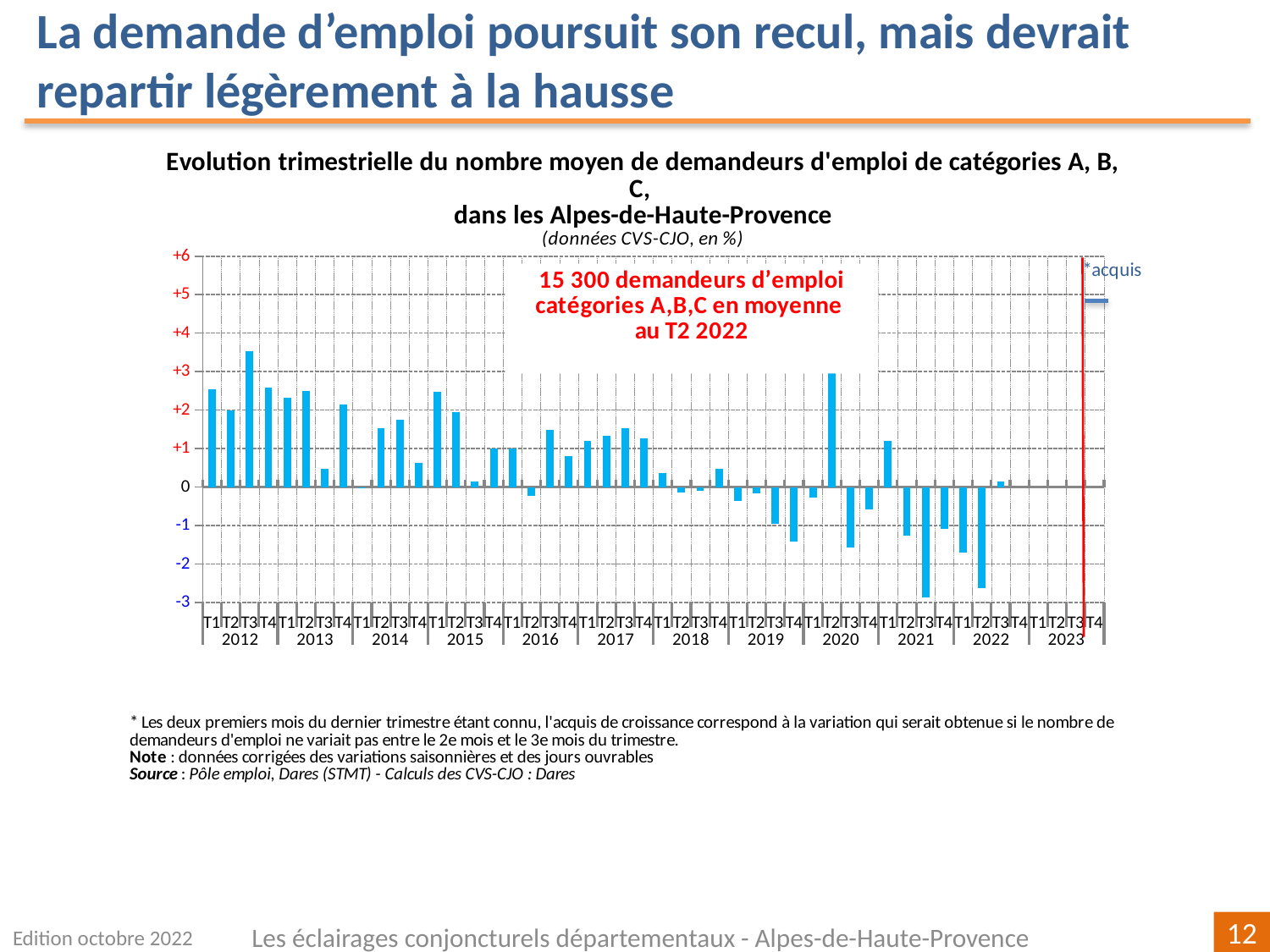
How many years are labelled along the x axis of the chart? 12 According to the text box on the chart, how many demandeurs d'emploi catégories A,B,C were there on average at T2 2022? 15 300 Between T1 2021 and T3 2021, do the values rise or fall? fall Which is lower, the value for T3 2021 or the value for T2 2022? T3 2021 Is the value for T4 2019 greater or less than -1? less What kind of chart is shown on the slide? bar chart Is the value for T1 2012 greater or less than +2? greater Which quarter has the lowest value on the chart? T3 2021 Is the value for T2 2020 greater or less than +2? greater